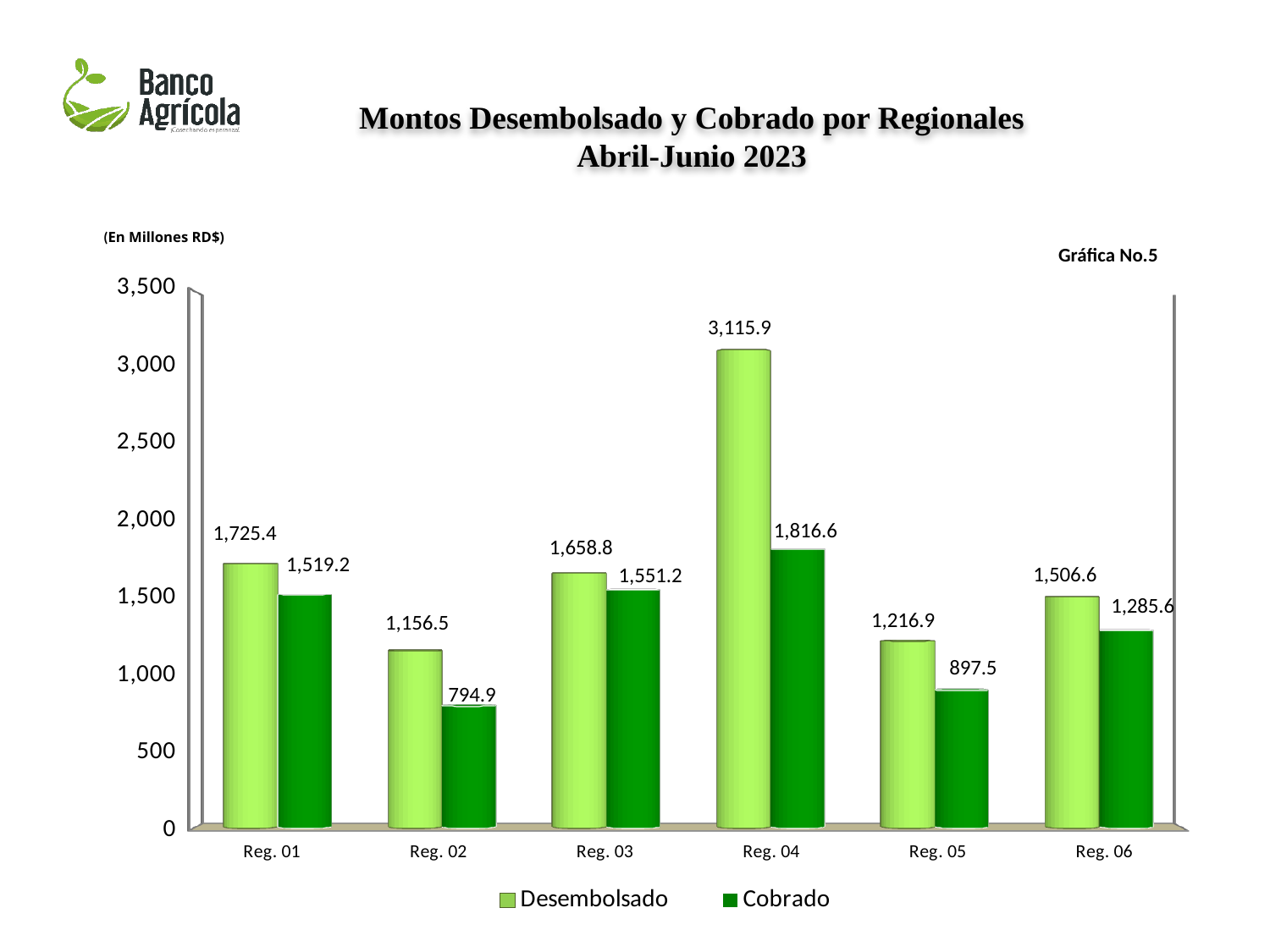
What is the Desembolsado value for Reg. 04? 3,115.9 What kind of chart is shown on the slide? Bar chart Is the Desembolsado value for Reg. 01 greater or less than 1,500? greater Which region has the lowest Cobrado value? Reg. 02 Which is larger for Reg. 05: Desembolsado or Cobrado? Desembolsado What is the difference between Desembolsado and Cobrado for Reg. 04? 1,299.3 What unit is stated for the values in the chart? En Millones RD$ Which region has the highest Desembolsado value? Reg. 04 How many regions are shown on the x axis? 6 How many series does the legend list? 2 What is the Cobrado value for Reg. 02? 794.9 What is the Cobrado value for Reg. 06? 1,285.6